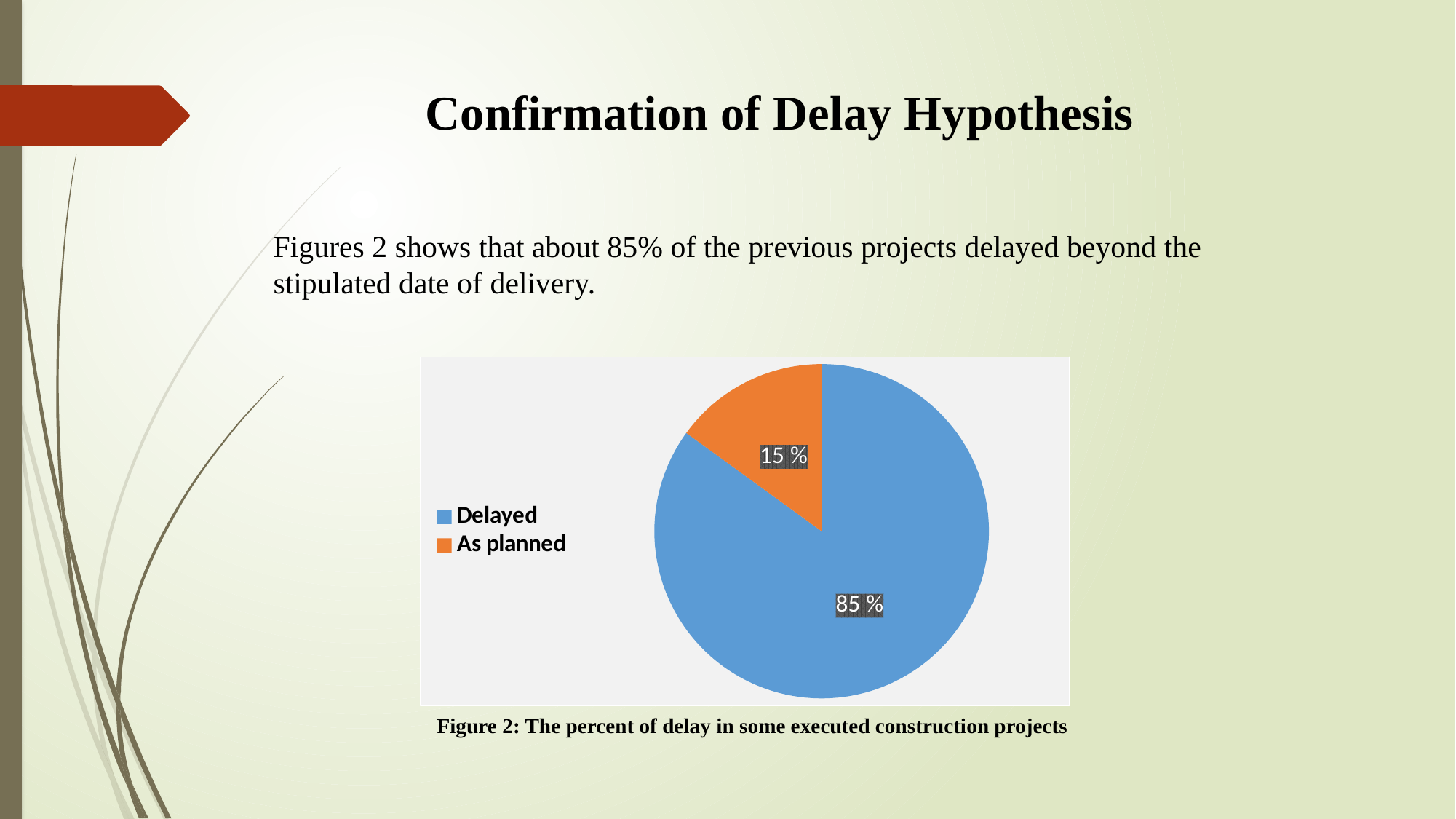
Which category has the largest slice of the pie? Delayed How many entries does the legend list? 2 What colour is the As planned slice? orange What kind of chart is shown on the slide? pie chart What is the value shown for the As planned slice? 15 % Which is larger, the Delayed slice or the As planned slice? Delayed Which category has the smallest slice of the pie? As planned What share of the pie does the Delayed slice represent? 85 % What is the caption of the figure below the chart? Figure 2: The percent of delay in some executed construction projects What is the value shown for the Delayed slice? 85 % How many categories does the pie chart show? 2 What is the difference between the Delayed and As planned percentages? 70 %